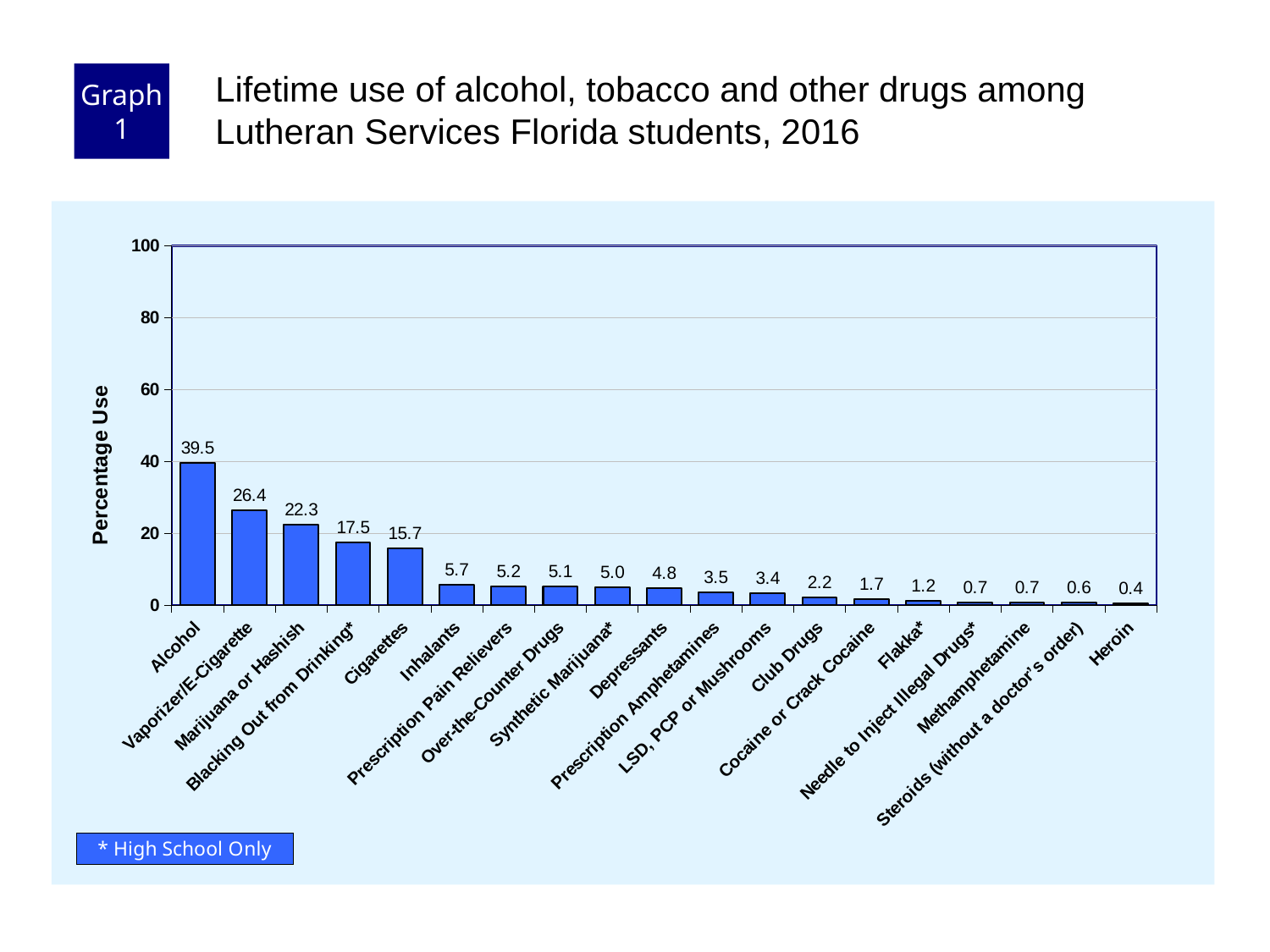
What is the label on the y axis of the chart? Percentage Use Which is larger, the value for Marijuana or Hashish or the value for Cigarettes? Marijuana or Hashish Which category has the highest lifetime use percentage? Alcohol What is the difference between the values for Alcohol and Vaporizer/E-Cigarette? 13.1 What is the value shown for Vaporizer/E-Cigarette? 26.4 What is the value shown for Cigarettes? 15.7 What is the value shown for Inhalants? 5.7 What kind of chart is shown on the slide? Bar chart What is the lifetime use percentage for Alcohol? 39.5 How many categories are shown on the x axis of the chart? 19 Do the values rise or fall moving from left to right along the x axis? Fall Which category has the lowest lifetime use percentage? Heroin